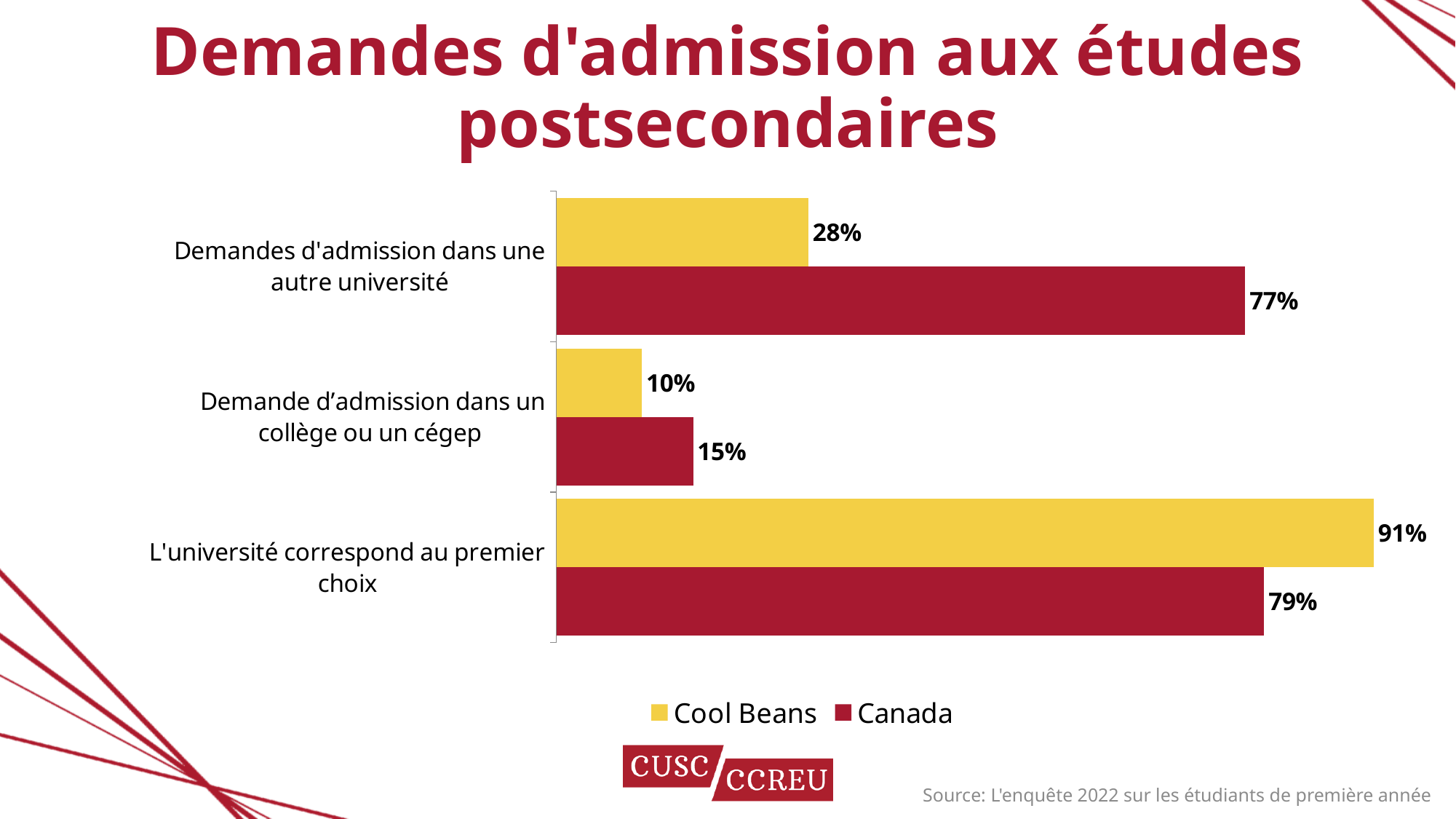
Which category has the lowest Canada value? Demande d'admission dans un collège ou un cégep Which category has the highest Cool Beans value? L'université correspond au premier choix How many categories are shown on the chart? 3 What is the Cool Beans value for "Demandes d'admission dans une autre université"? 28% What kind of chart is shown on the slide? Bar chart How many series does the legend list? 2 For "L'université correspond au premier choix", which series has the larger value, Cool Beans or Canada? Cool Beans What is the difference between the Canada and Cool Beans values for "Demandes d'admission dans une autre université"? 49% What is the Cool Beans value for "Demande d'admission dans un collège ou un cégep"? 10% Which colour represents the Canada series in the chart? Dark red What is the Canada value for "Demandes d'admission dans une autre université"? 77% What is the Canada value for "L'université correspond au premier choix"? 79%